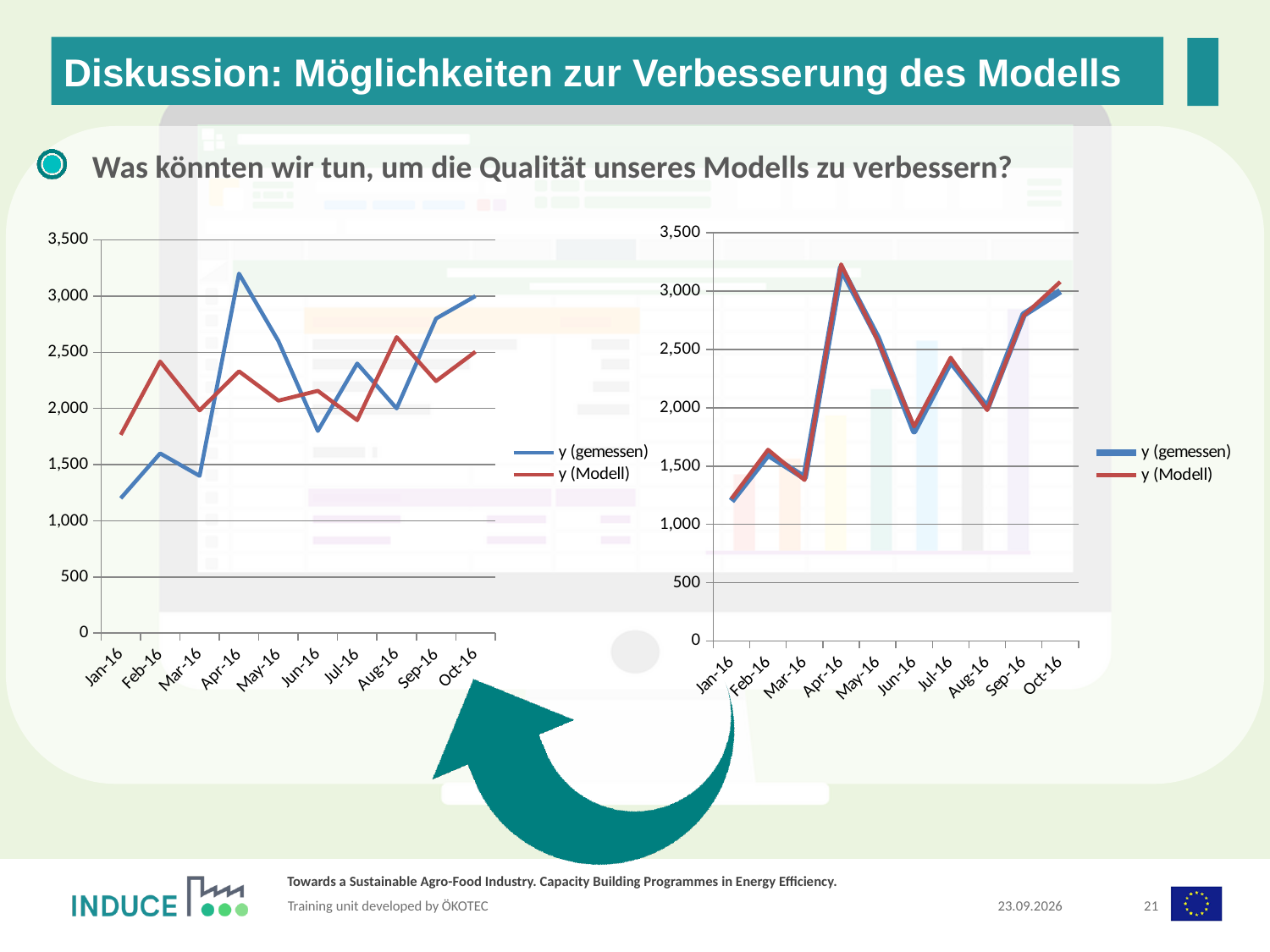
In the right chart, is the value of y (Modell) for Apr-16 greater or less than 3,000? greater In the left chart, what colour is the line for y (Modell)? red In the left chart, is the value of y (Modell) for Jan-16 greater or less than 2,000? less What are the two legend entries of the right chart? y (gemessen) and y (Modell) In the left chart, which month has the highest value for y (gemessen)? Apr-16 What kind of chart is the chart on the left side of the slide? line chart How many series does the legend of the left chart list? 2 In the right chart, which month has the lowest value for y (gemessen)? Jan-16 In the left chart, which month has the lowest value for y (gemessen)? Jan-16 In the left chart, which is larger for Apr-16: y (gemessen) or y (Modell)? y (gemessen) In the left chart, is the value of y (gemessen) for Apr-16 greater or less than 3,000? greater How many months are shown on the x axis of the right chart? 10